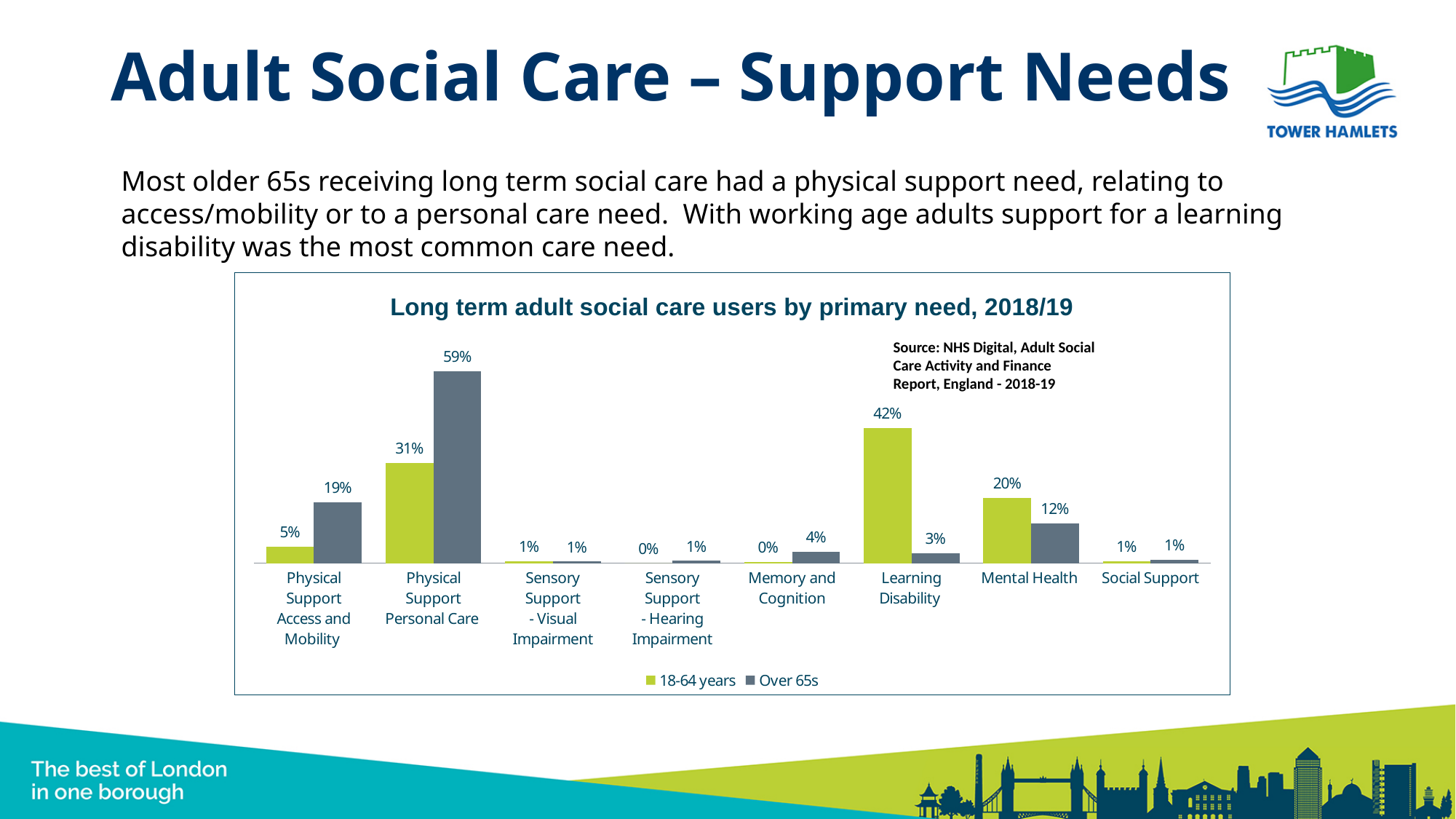
How many series does the legend list? 2 Which category has the highest value for the 18-64 years series? Learning Disability What is the difference between the 18-64 years and Over 65s values for Learning Disability? 39% What is the value for 18-64 years in the Learning Disability category? 42% Which category has the highest value for the Over 65s series? Physical Support Personal Care What is the difference between the Over 65s and 18-64 years values for Physical Support Personal Care? 28% What is the title of the chart? Long term adult social care users by primary need, 2018/19 Which is larger for Mental Health: the 18-64 years value or the Over 65s value? 18-64 years What is the value for Over 65s in the Mental Health category? 12% What kind of chart is shown on the slide? Bar chart How many categories are shown on the x axis? 8 What is the value for Over 65s in the Physical Support Personal Care category? 59%